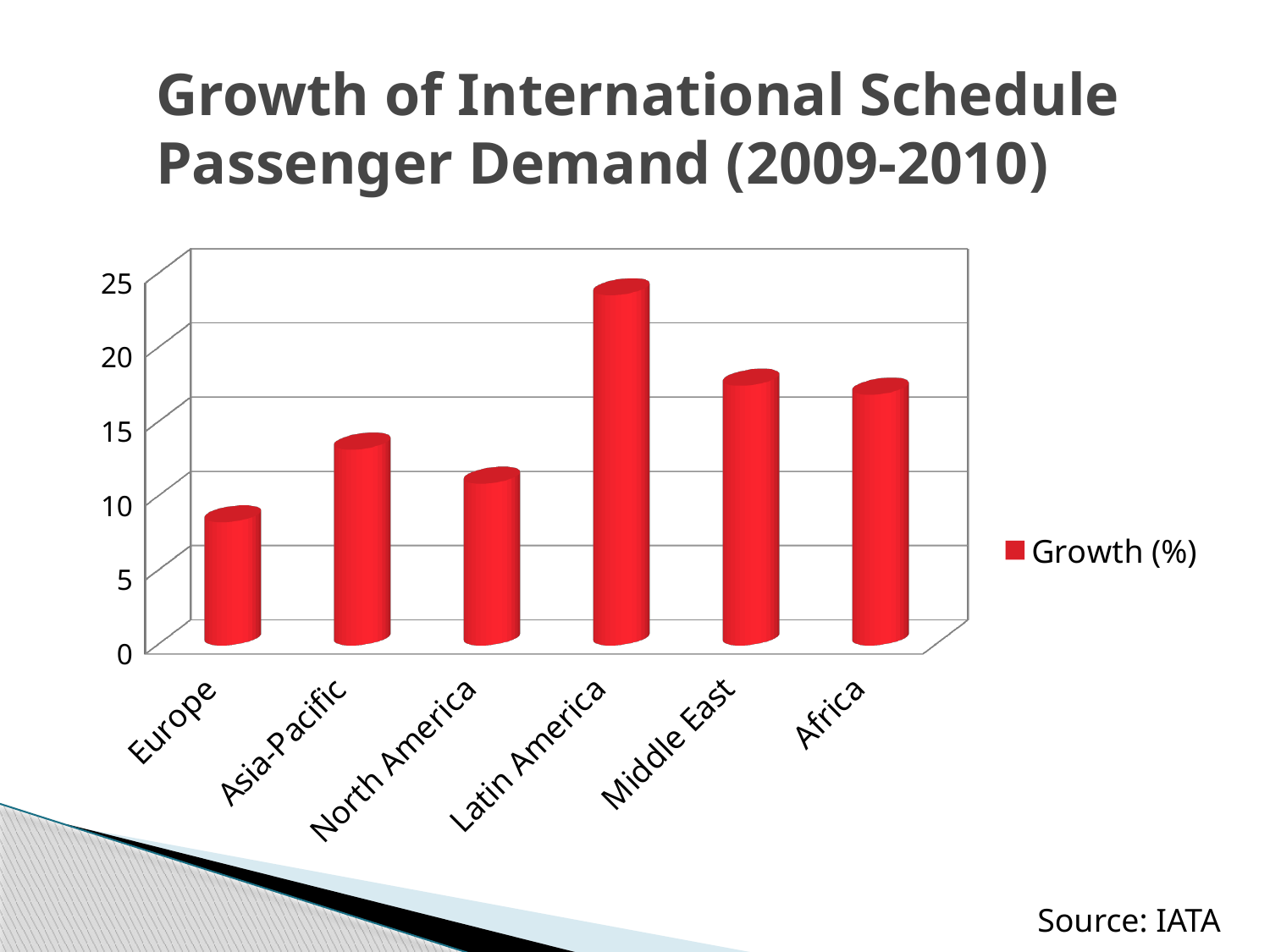
Which region has the lowest growth? Europe How many series does the legend list? 1 Which region has the highest growth? Latin America Is the value for Latin America greater or less than 20? greater Which is larger, the value for Europe or the value for Africa? Africa How many regions are plotted on the chart? 6 Which is larger, the value for Asia-Pacific or the value for North America? Asia-Pacific What kind of chart is shown on the slide? bar chart Is the value for Middle East greater or less than 15? greater Is the value for Europe greater or less than 10? less What is the name of the series shown in the legend? Growth (%)